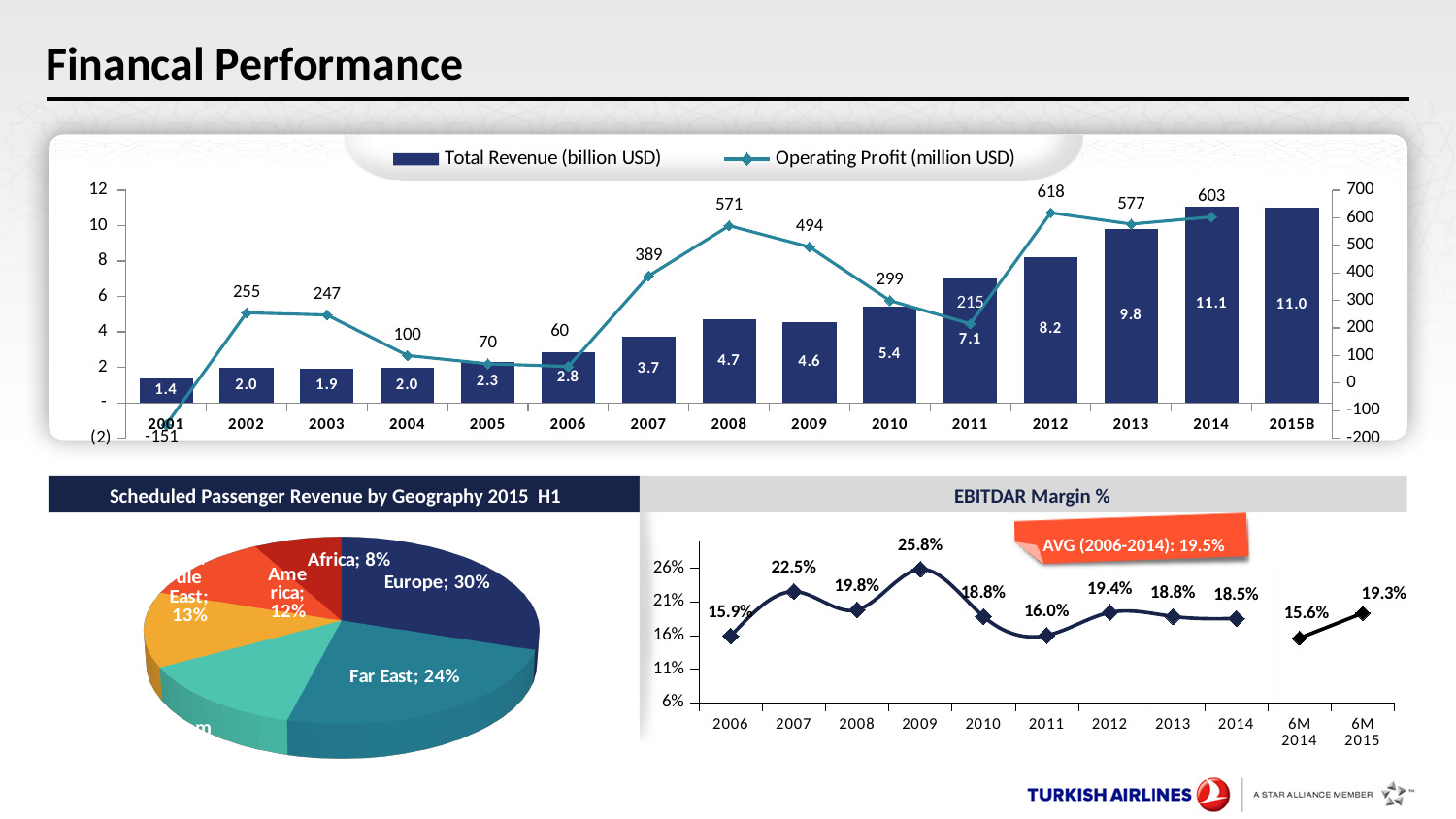
In the 'EBITDAR Margin %' chart, what is the value for 6M 2015? 19.3% In the top chart, which year has the lowest Total Revenue? 2001 In the 'EBITDAR Margin %' chart, which year between 2006 and 2014 has the highest margin? 2009 In the top chart, which year has the highest Operating Profit? 2012 In the top chart, what is the Operating Profit (million USD) for 2008? 571 In the top chart, what is the difference in Total Revenue between 2014 and 2013? 1.3 What type of chart is the 'EBITDAR Margin %' chart? Line chart In the 'Scheduled Passenger Revenue by Geography 2015 H1' pie chart, what share does Europe have? 30% In the top chart, which is larger: Operating Profit in 2008 or in 2009? 2008 In the top chart, what is the Total Revenue (billion USD) for 2014? 11.1 In the 'Scheduled Passenger Revenue by Geography 2015 H1' pie chart, which is larger: Far East or Africa? Far East How many series does the legend of the top chart list? 2